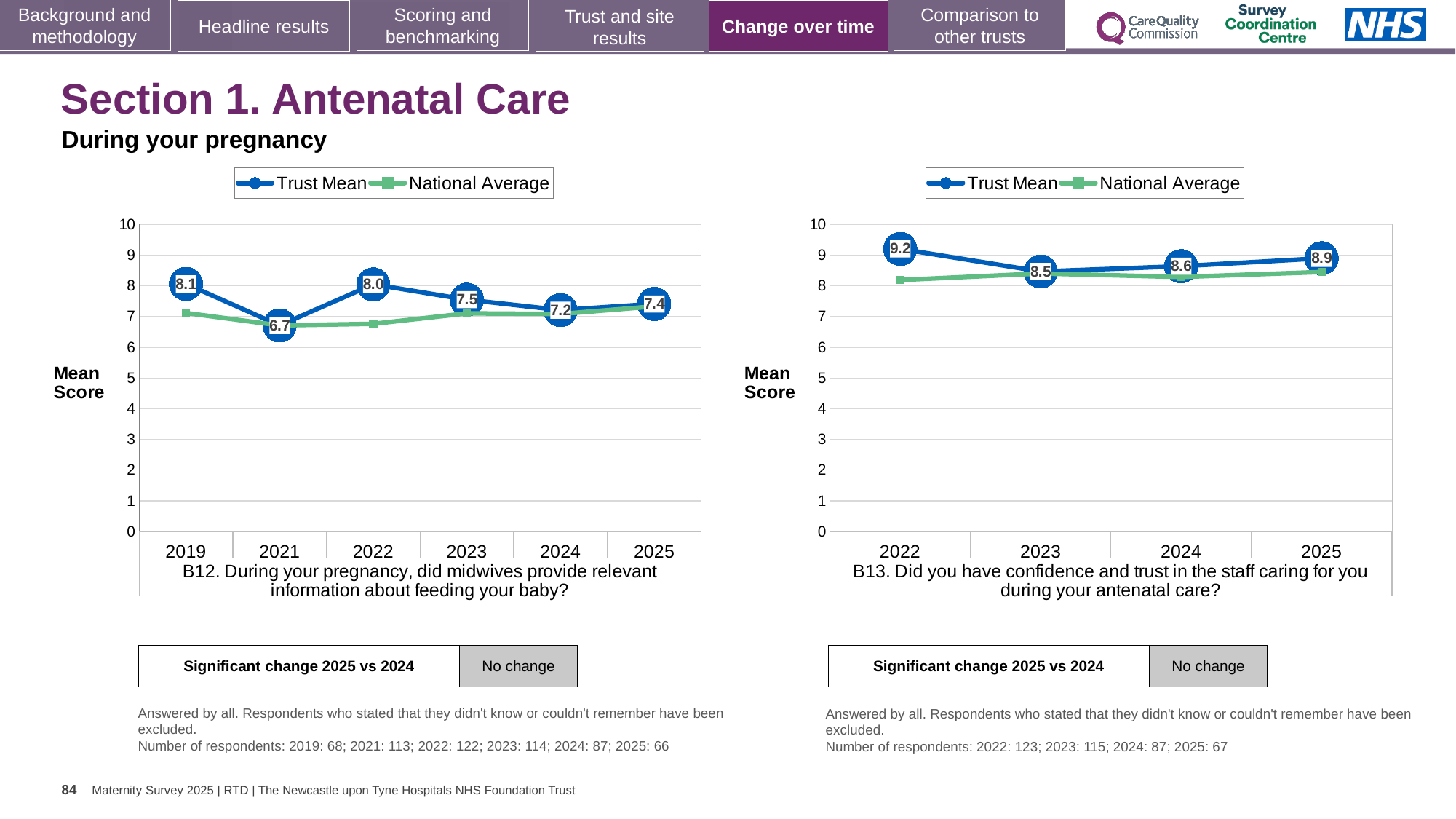
In the B13 chart (right), is the Trust Mean score for 2022 larger or smaller than the score for 2025? larger In the B12 chart (left), what is the difference between the Trust Mean scores for 2022 and 2021? 1.3 In the B13 chart (right), what is the Trust Mean score for 2022? 9.2 In the B12 chart (left), which year has the highest Trust Mean score? 2019 In the B13 chart (right), which year has the lowest Trust Mean score? 2023 In the B12 chart (left), what is the Trust Mean score for 2019? 8.1 In the B12 chart (left), which year has the lowest Trust Mean score? 2021 In the B13 chart (right), what is the Trust Mean score for 2025? 8.9 In the B12 chart (left), how many years are plotted on the x axis? 6 In the B13 chart (right), is the National Average value for 2022 greater or less than 9? less How many series does the legend of the B13 chart (right) list? 2 In the B12 chart (left), what is the Trust Mean score for 2021? 6.7